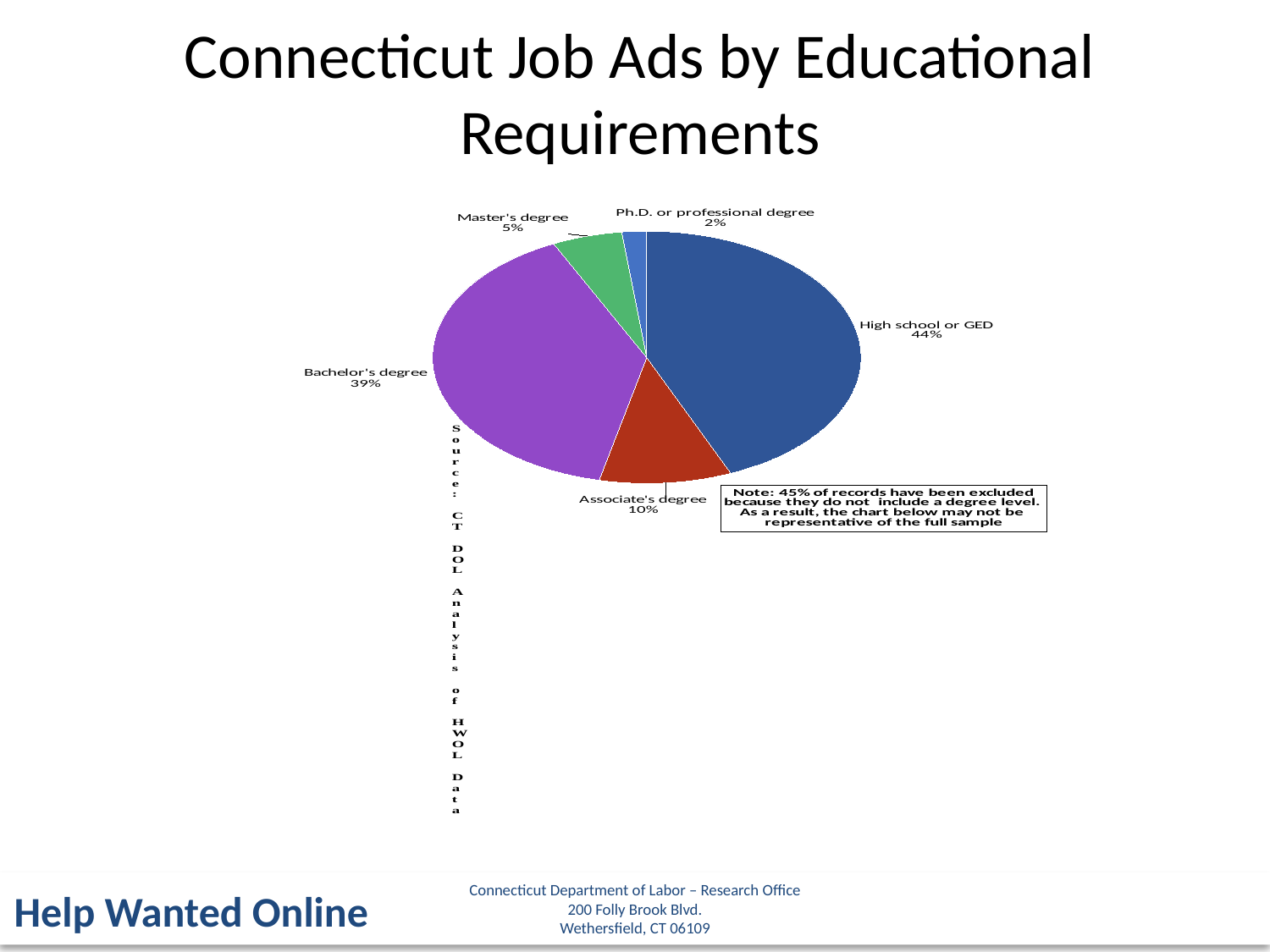
What is the title of the slide? Connecticut Job Ads by Educational Requirements How many educational requirement categories are shown in the pie chart? 5 What share of job ads require a high school diploma or GED? 44% What share of job ads require a Ph.D. or professional degree? 2% Which is larger, the share for Associate's degree or the share for Master's degree? Associate's degree What share of job ads require an Associate's degree? 10% What kind of chart is shown on the slide? pie chart Which educational requirement has the largest share of job ads? High school or GED What share of job ads require a Bachelor's degree? 39% How many percentage points larger is the High school or GED share than the Bachelor's degree share? 5 Which educational requirement has the smallest share of job ads? Ph.D. or professional degree What share of job ads require a Master's degree? 5%